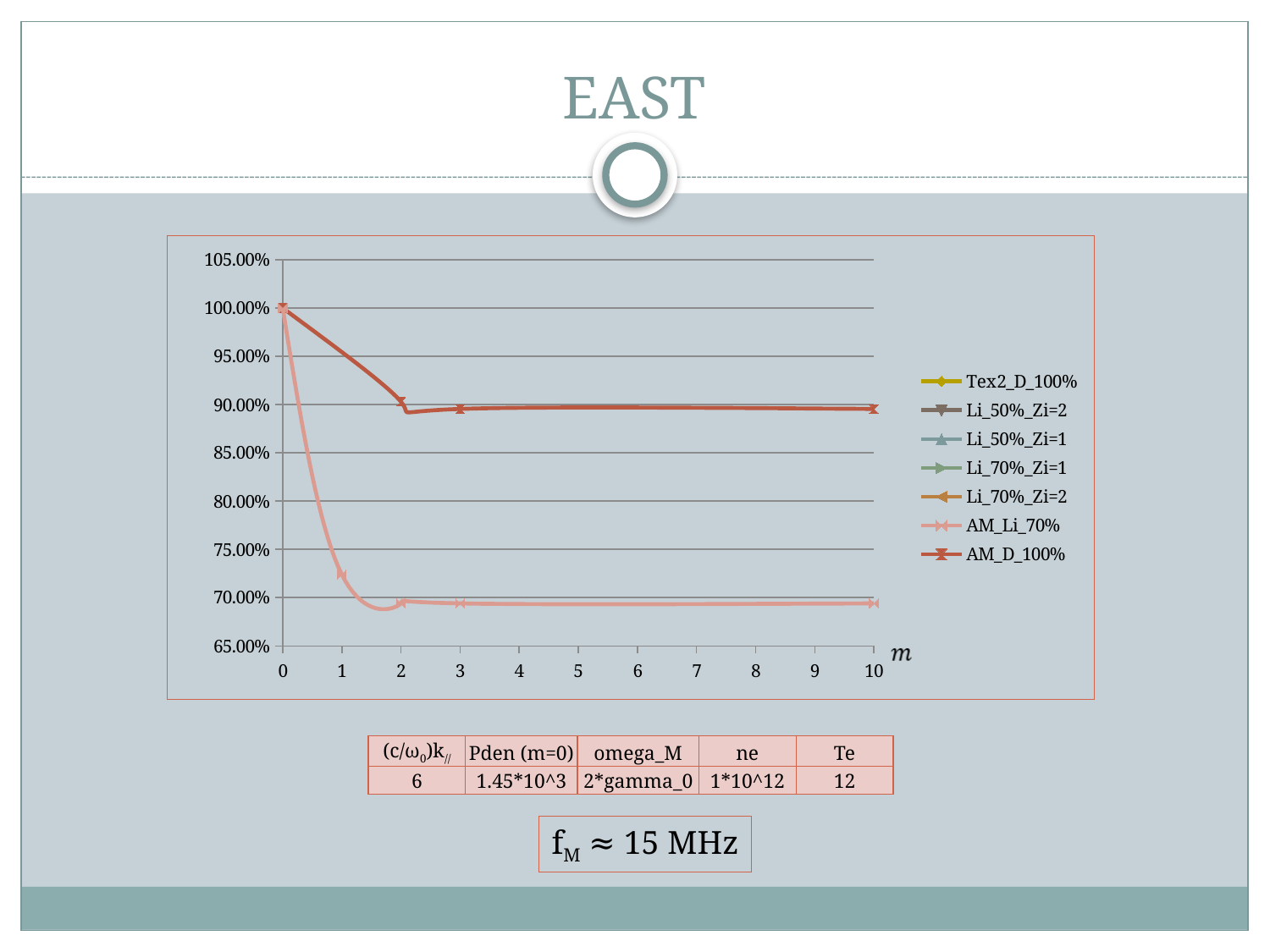
Does the AM_Li_70% series rise or fall from m = 0 to m = 2? fall How many series does the chart legend list? 7 Is the value of the AM_D_100% series at m = 10 greater or less than 85%? greater At m = 10, which series has the higher value, AM_D_100% or AM_Li_70%? AM_D_100% What is the value of the AM_Li_70% series at m = 0? 100.00% What is the label on the x axis of the chart? m What is the highest value shown on the y axis of the chart? 105.00% What kind of chart is shown on the slide? line chart What is the value of the AM_D_100% series at m = 0? 100.00% Is the value of the AM_Li_70% series at m = 1 greater or less than 80%? less Is the value of the AM_Li_70% series at m = 10 greater or less than 75%? less